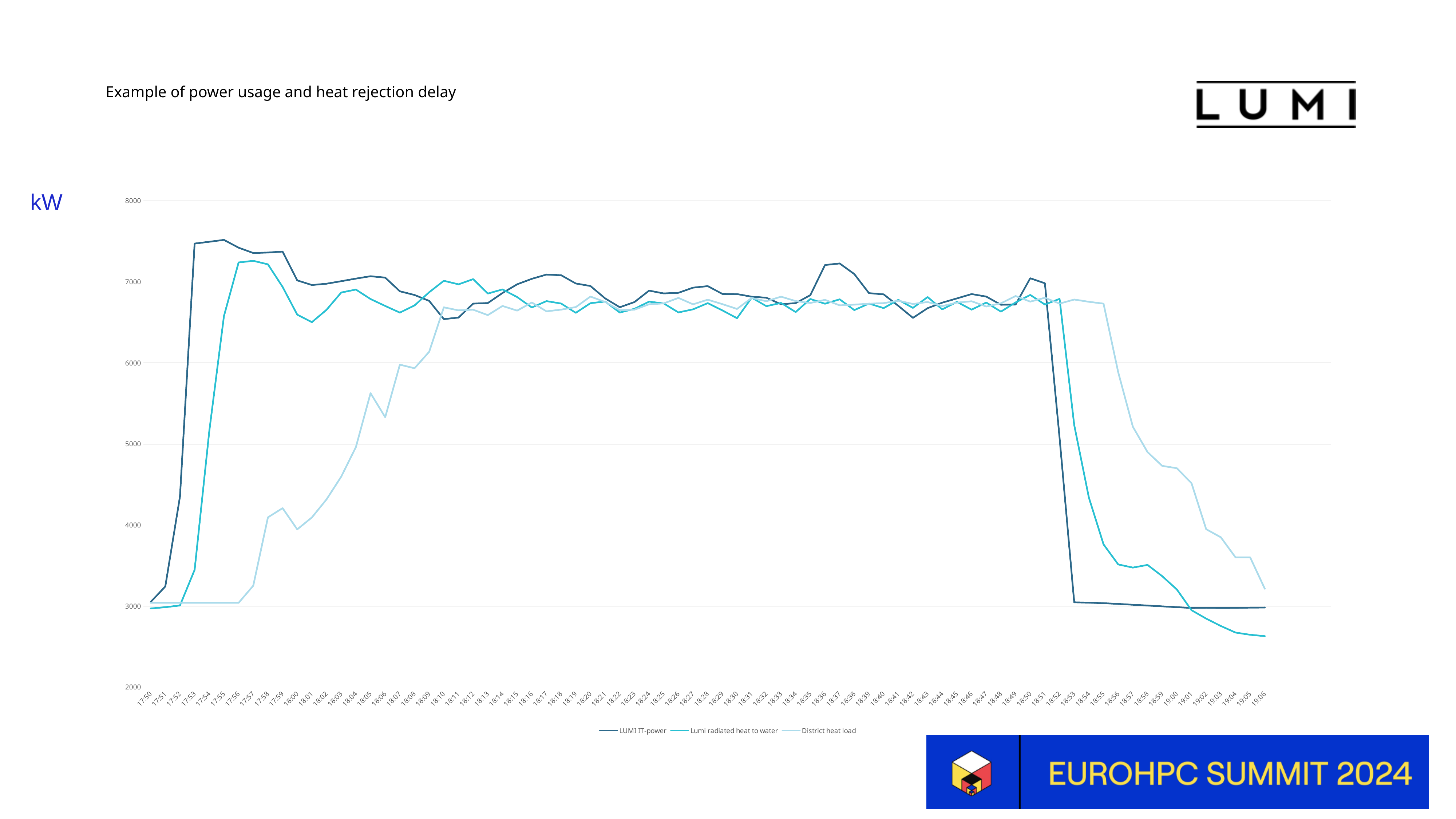
Is the value for District heat load at 18:00 greater or less than 5000? less Is the value for LUMI IT-power at 18:53 greater or less than 4000? less What kind of chart is shown on the slide? line chart What is the title of the chart? Example of power usage and heat rejection delay At 19:04, which series has the higher value, District heat load or LUMI IT-power? District heat load Is the value for Lumi radiated heat to water at 19:06 greater or less than 3000? less What unit is shown for the y axis? kW How many series does the legend list? 3 At 18:00, which series has the higher value, LUMI IT-power or District heat load? LUMI IT-power Does the District heat load series rise or fall between 18:55 and 19:06? fall